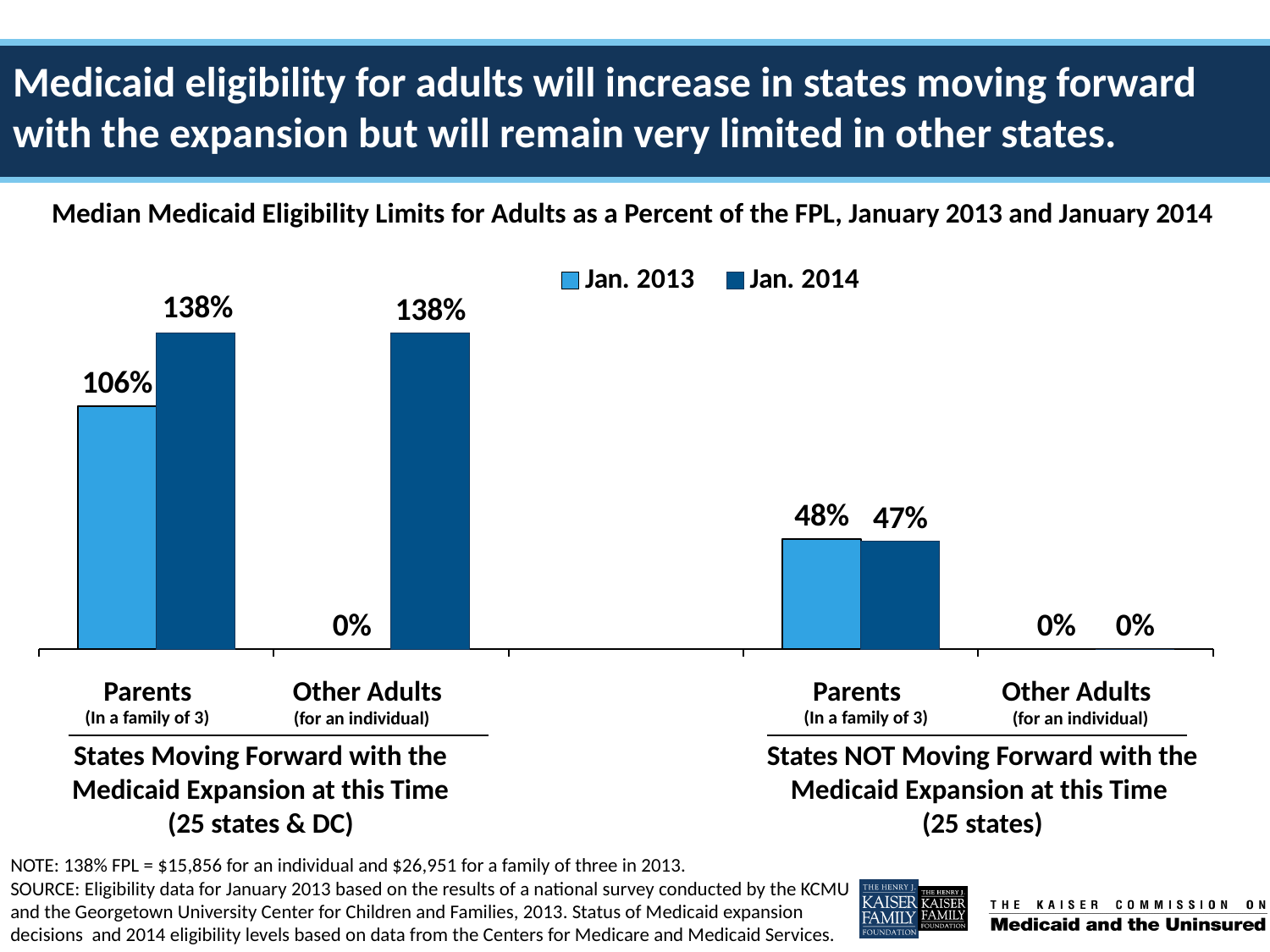
How many states (plus DC) are in the group moving forward with the Medicaid expansion, according to the chart label? 25 states & DC What is the Jan. 2013 median eligibility limit for Parents in states NOT moving forward with the Medicaid expansion? 48% What is the Jan. 2013 median Medicaid eligibility limit for Parents in states moving forward with the Medicaid expansion? 106% How many series does the legend list? 2 What is the Jan. 2013 median eligibility limit for Other Adults in states moving forward with the expansion? 0% What type of chart is shown on the slide? Bar chart What is the difference between the Jan. 2014 eligibility limit for Other Adults in states moving forward and in states not moving forward with the expansion? 138 percentage points By how many percentage points does the Parents eligibility limit in states moving forward with the expansion increase from Jan. 2013 to Jan. 2014? 32 percentage points What are the two series named in the legend? Jan. 2013 and Jan. 2014 Which is larger: the Jan. 2013 Parents eligibility limit in states moving forward with the expansion or in states not moving forward? States moving forward (106%) What is the Jan. 2014 median Medicaid eligibility limit for Parents in states moving forward with the Medicaid expansion? 138% What is the Jan. 2014 median eligibility limit for Parents in states NOT moving forward with the Medicaid expansion? 47%